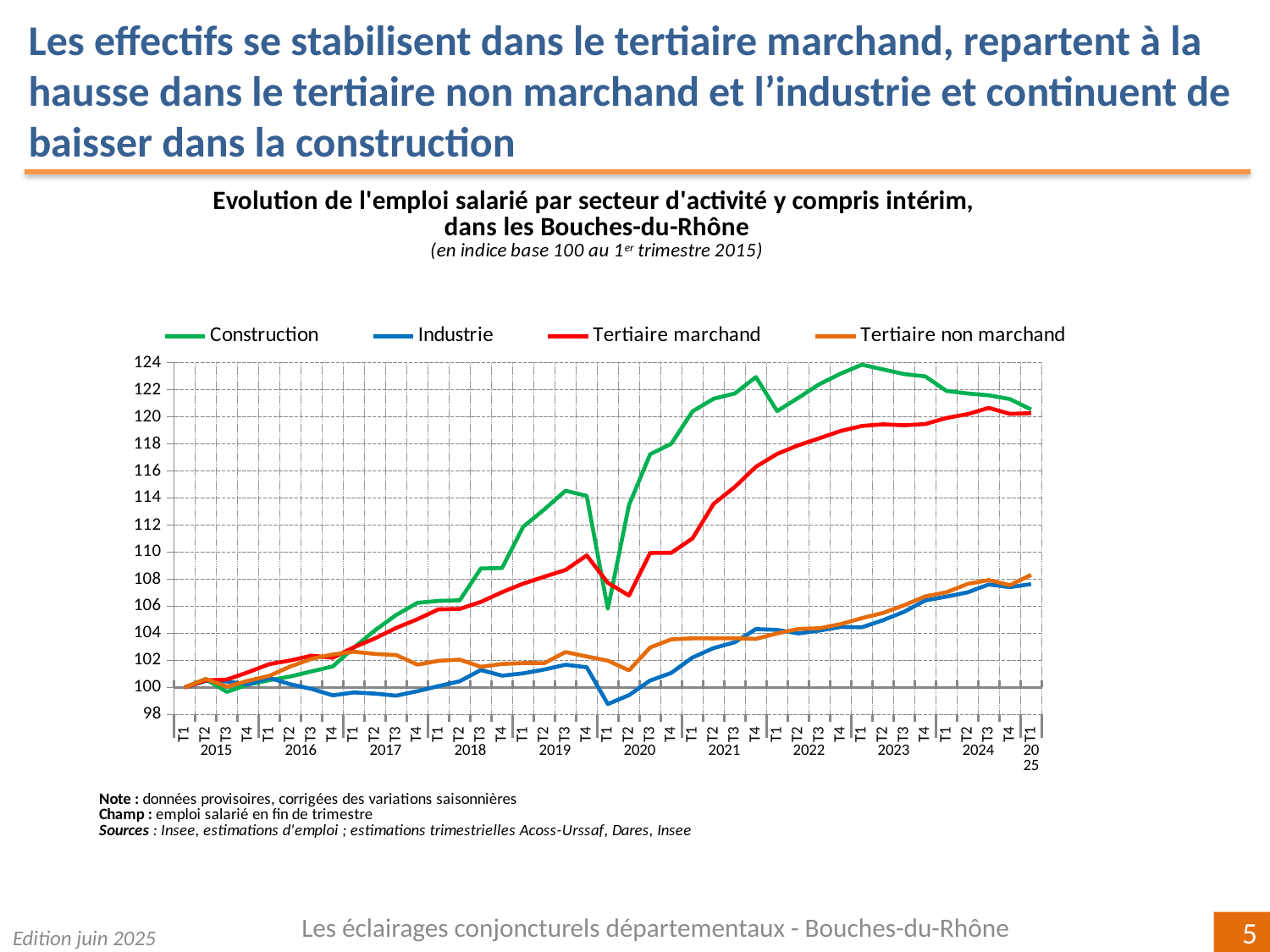
What kind of chart is shown on the slide? line chart Which series has the lowest value at T1 2020? Industrie How many series does the legend list? 4 Which colour is used for the Tertiaire non marchand series? orange Does the Construction series rise or fall between T1 2023 and T1 2025? fall Does the Industrie series rise or fall overall between 2015 and 2025? rise Which series has the highest value at T1 2023? Construction What is the index value of the Construction series at T1 2015? 100 Is the value for Tertiaire marchand at T1 2024 greater or less than 118? greater Is the value for Construction at T1 2023 greater or less than 122? greater At T1 2019, which series is higher: Construction or Industrie? Construction Is the value for Industrie at T1 2020 greater or less than 100? less